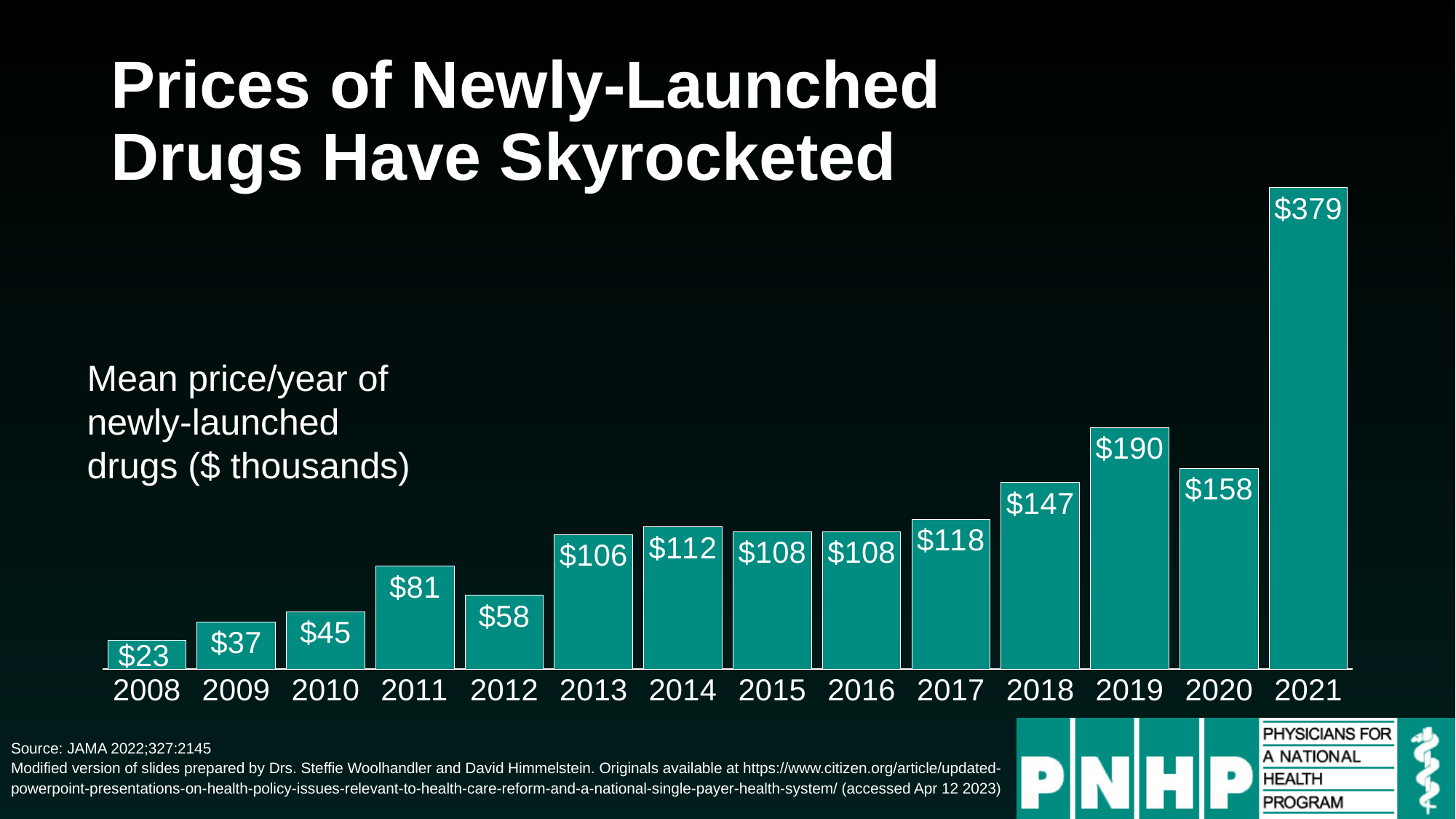
What is the mean price/year of newly-launched drugs in 2021? $379 What is the value shown for 2008? $23 What is the title of the slide? Prices of Newly-Launched Drugs Have Skyrocketed What is the difference between the values for 2021 and 2020? $221 Which year has the lowest value? 2008 What kind of chart is shown on the slide? bar chart Do the values generally rise or fall from 2008 to 2021? rise What is the difference between the values for 2019 and 2018? $43 Which year has the highest value? 2021 What is the value shown for 2019? $190 How many years are shown on the x axis? 14 Which is larger, the value for 2011 or the value for 2012? 2011